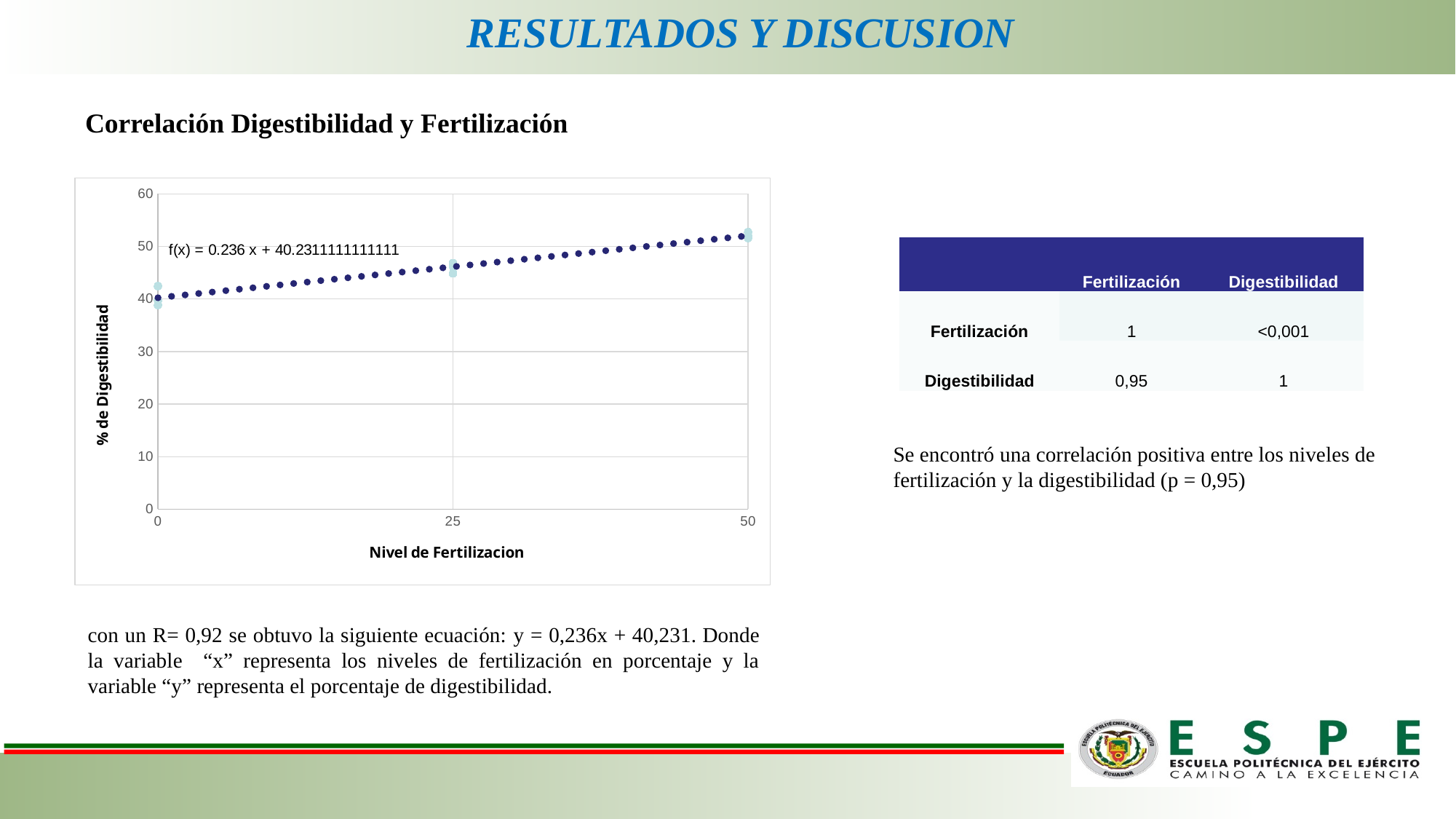
Do the plotted digestibility values rise or fall as the fertilization level increases along the x axis? rise What is the title of the y axis of the chart? % de Digestibilidad What is the slope of the trendline equation shown on the chart? 0.236 What is the trendline equation printed on the chart? f(x) = 0.236 x + 40.2311111111111 How many fertilization levels are marked on the x axis of the chart? 3 Is the digestibility value at fertilization level 0 greater or less than 50? less Which fertilization level, 0 or 50, has the higher digestibility values? 50 What kind of chart is shown on the slide? scatter chart Is the digestibility value at fertilization level 25 greater or less than 40? greater What is the title of the x axis of the chart? Nivel de Fertilizacion Is the digestibility value at fertilization level 50 greater or less than 40? greater